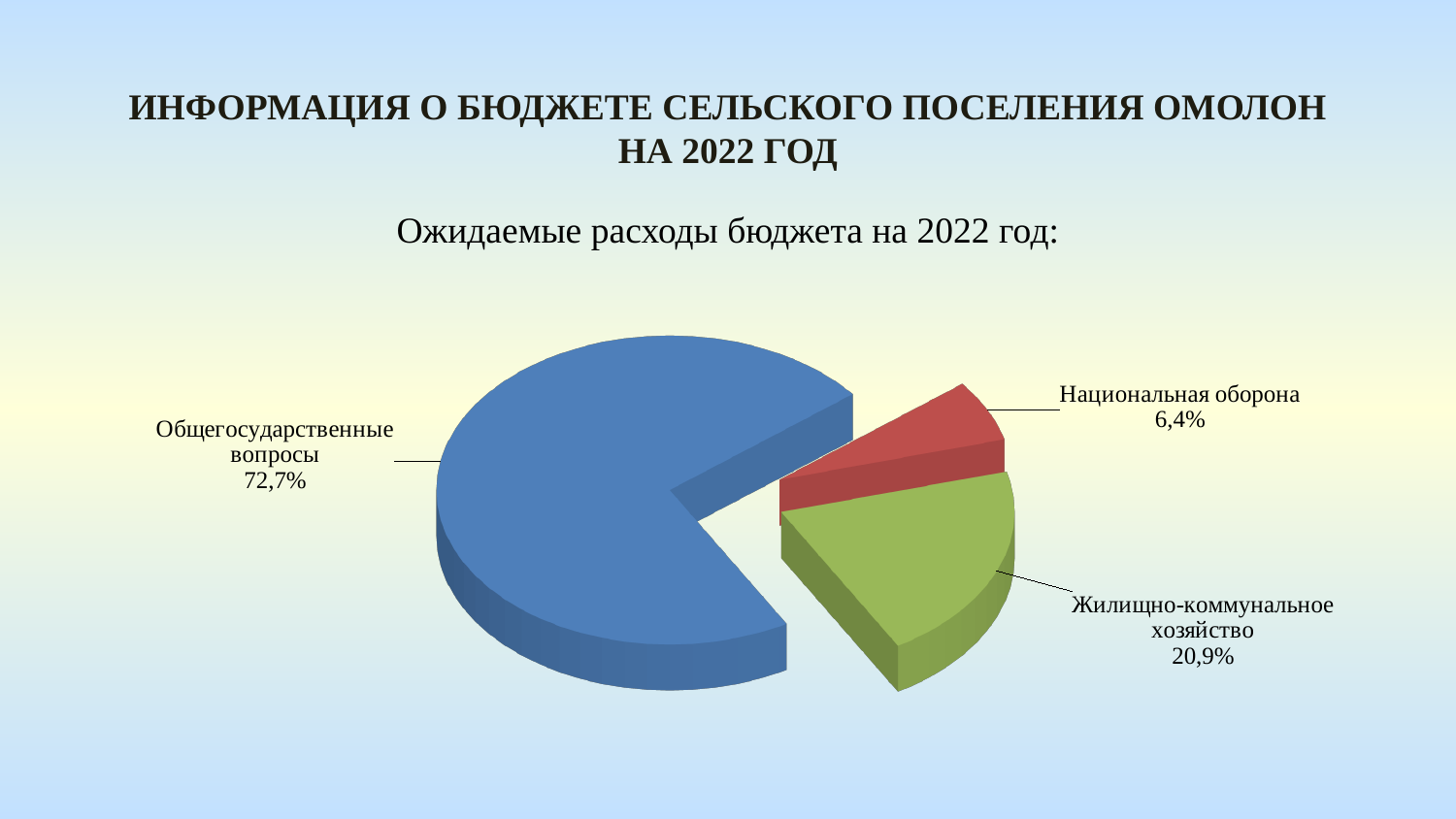
Which category has the smallest slice of the pie? Национальная оборона Which category has the largest slice of the pie? Общегосударственные вопросы What kind of chart is shown on the slide? Pie chart What is the difference in percentage points between Жилищно-коммунальное хозяйство and Национальная оборона? 14,5 Which is larger: the share for Жилищно-коммунальное хозяйство or the share for Национальная оборона? Жилищно-коммунальное хозяйство What is the value shown for Жилищно-коммунальное хозяйство? 20,9% How many categories are shown in the pie chart? 3 What is the value shown for Национальная оборона? 6,4% What colour is the slice for Национальная оборона? Red What share of the pie does Общегосударственные вопросы represent? 72,7% What is the difference in percentage points between Общегосударственные вопросы and Жилищно-коммунальное хозяйство? 51,8 What is the subtitle above the chart? Ожидаемые расходы бюджета на 2022 год: